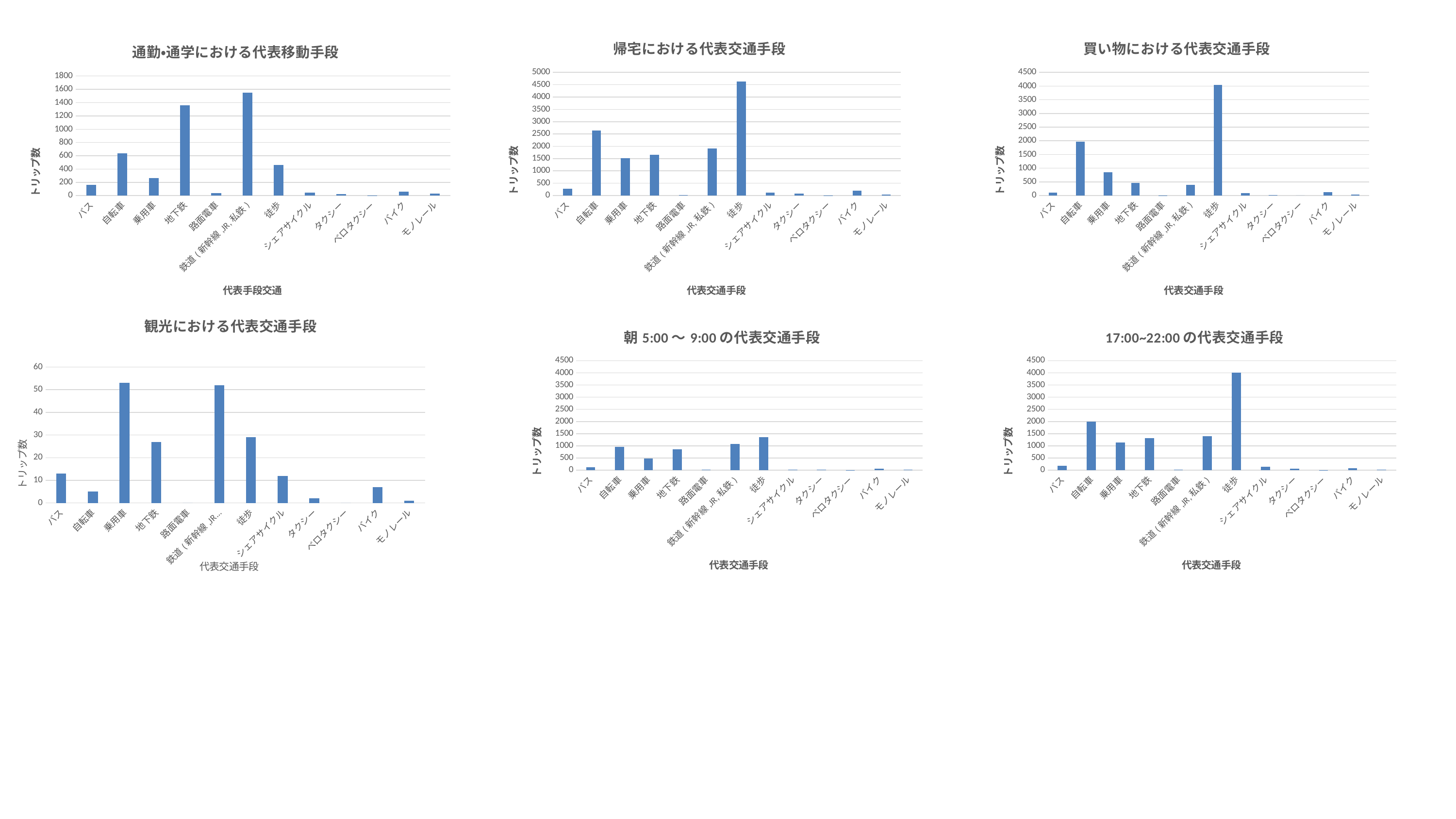
In the 買い物における代表交通手段 chart, which transport mode has the highest number of trips? 徒歩 In the 通勤•通学における代表移動手段 chart, is the value for 地下鉄 greater or less than 1200? greater In the 観光における代表交通手段 chart, which is larger, the value for 地下鉄 or the value for シェアサイクル? 地下鉄 In the 通勤•通学における代表移動手段 chart, which transport mode has the highest number of trips? 鉄道（新幹線,JR,私鉄） In the 朝 5:00 〜 9:00 の代表交通手段 chart, which transport mode has the highest number of trips? 徒歩 What kind of chart is the 通勤•通学における代表移動手段 chart? bar chart In the 帰宅における代表交通手段 chart, is the value for 自転車 greater or less than 2000? greater In the 17:00~22:00 の代表交通手段 chart, is the value for 鉄道（新幹線,JR,私鉄） greater or less than 1000? greater How many transport mode categories are shown on the x axis of the 帰宅における代表交通手段 chart? 12 In the 買い物における代表交通手段 chart, which is larger, the value for 自転車 or the value for 乗用車? 自転車